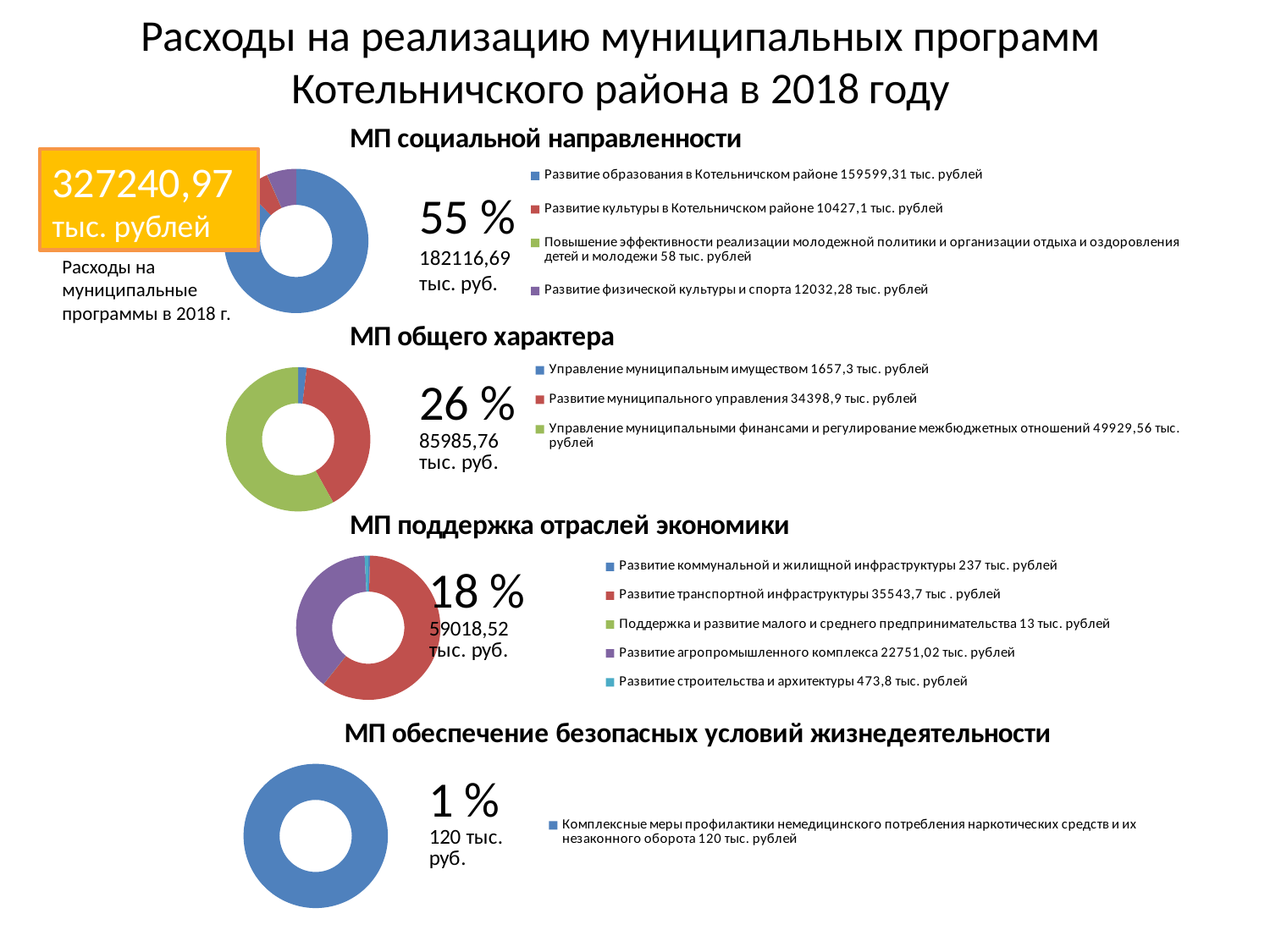
What share of total expenditure does 'МП обеспечение безопасных условий жизнедеятельности' represent, according to the slide? 1 % In the chart 'МП поддержка отраслей экономики', which legend entry has the smallest value? Поддержка и развитие малого и среднего предпринимательства In the chart 'МП поддержка отраслей экономики', how many categories are shown? 5 In the chart 'МП общего характера', which legend entry has the largest value? Управление муниципальными финансами и регулирование межбюджетных отношений In the chart 'МП социальной направленности', which legend entry has the smallest value? Повышение эффективности реализации молодежной политики и организации отдыха и оздоровления детей и молодежи In the chart 'МП социальной направленности', what is the value for 'Развитие образования в Котельничском районе'? 159599,31 тыс. рублей In the chart 'МП общего характера', how many legend entries are listed? 3 In the chart 'МП общего характера', what is the value for 'Развитие муниципального управления'? 34398,9 тыс. рублей In the chart 'МП поддержка отраслей экономики', what is the value for 'Развитие агропромышленного комплекса'? 22751,02 тыс. рублей In the chart 'МП социальной направленности', which is larger: 'Развитие культуры в Котельничском районе' or 'Развитие физической культуры и спорта'? Развитие физической культуры и спорта What kind of chart is used for 'МП общего характера'? Doughnut chart In the chart 'МП поддержка отраслей экономики', what is the difference between 'Развитие транспортной инфраструктуры' and 'Развитие агропромышленного комплекса'? 12792,68 тыс. рублей